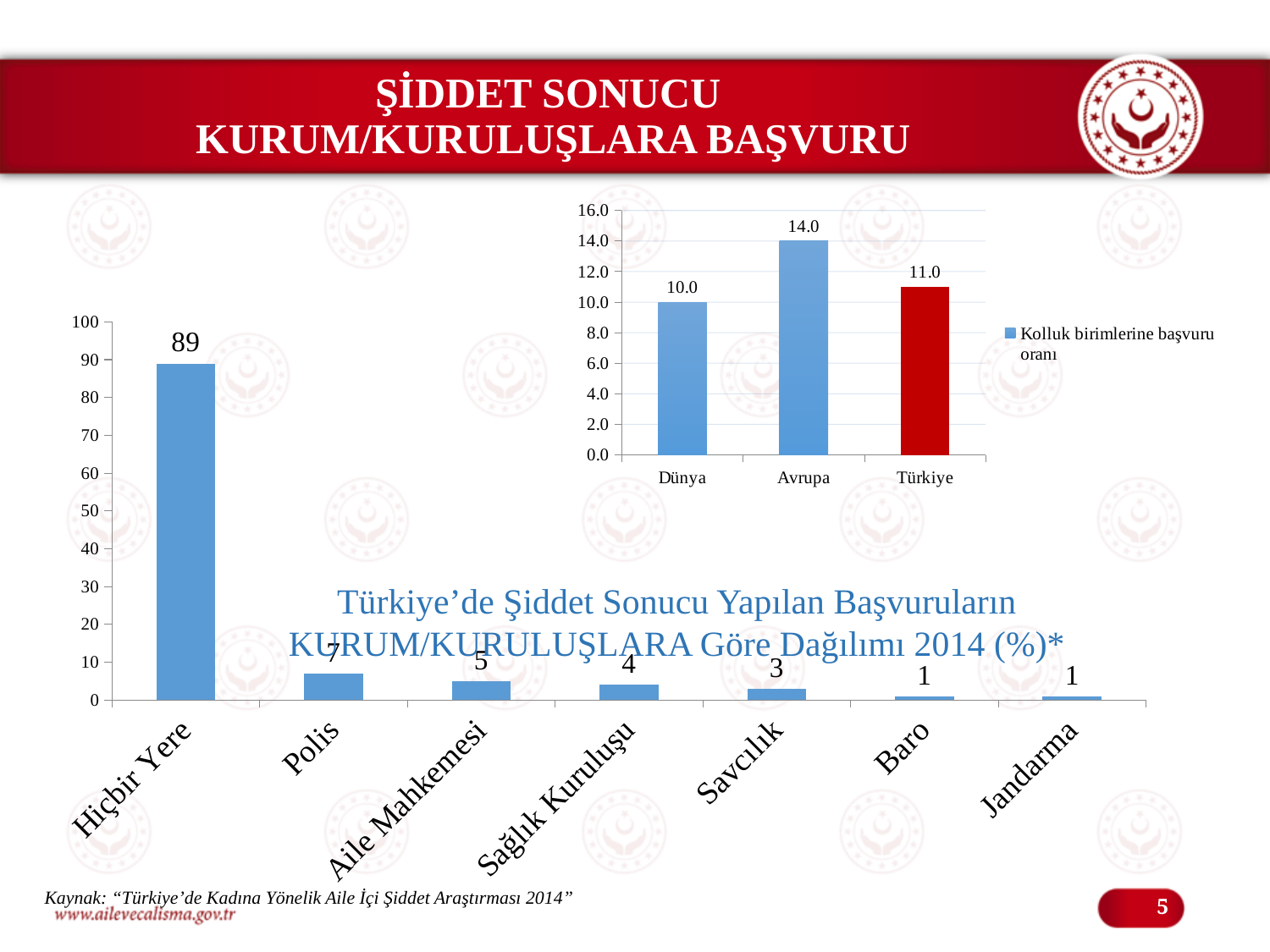
In the large chart at the bottom of the slide, what is the value for Polis? 7 In the smaller chart at the top right of the slide, what is the value for Avrupa? 14.0 In the large chart at the bottom of the slide, what is the difference between the values for Polis and Savcılık? 4 In the smaller chart at the top right of the slide, what is the value for Türkiye? 11.0 In the large chart at the bottom of the slide, which category has the highest value? Hiçbir Yere What kind of chart is the large chart at the bottom of the slide? Bar chart In the large chart 'Türkiye'de Şiddet Sonucu Yapılan Başvuruların KURUM/KURULUŞLARA Göre Dağılımı 2014 (%)', what is the value for Hiçbir Yere? 89 What series name does the legend of the smaller chart at the top right of the slide show? Kolluk birimlerine başvuru oranı How many categories are shown in the large chart at the bottom of the slide? 7 In the smaller chart at the top right of the slide, what is the difference between the values for Avrupa and Dünya? 4.0 In the smaller chart at the top right of the slide, which category has the lowest value? Dünya In the large chart at the bottom of the slide, which is larger, the value for Aile Mahkemesi or the value for Sağlık Kuruluşu? Aile Mahkemesi